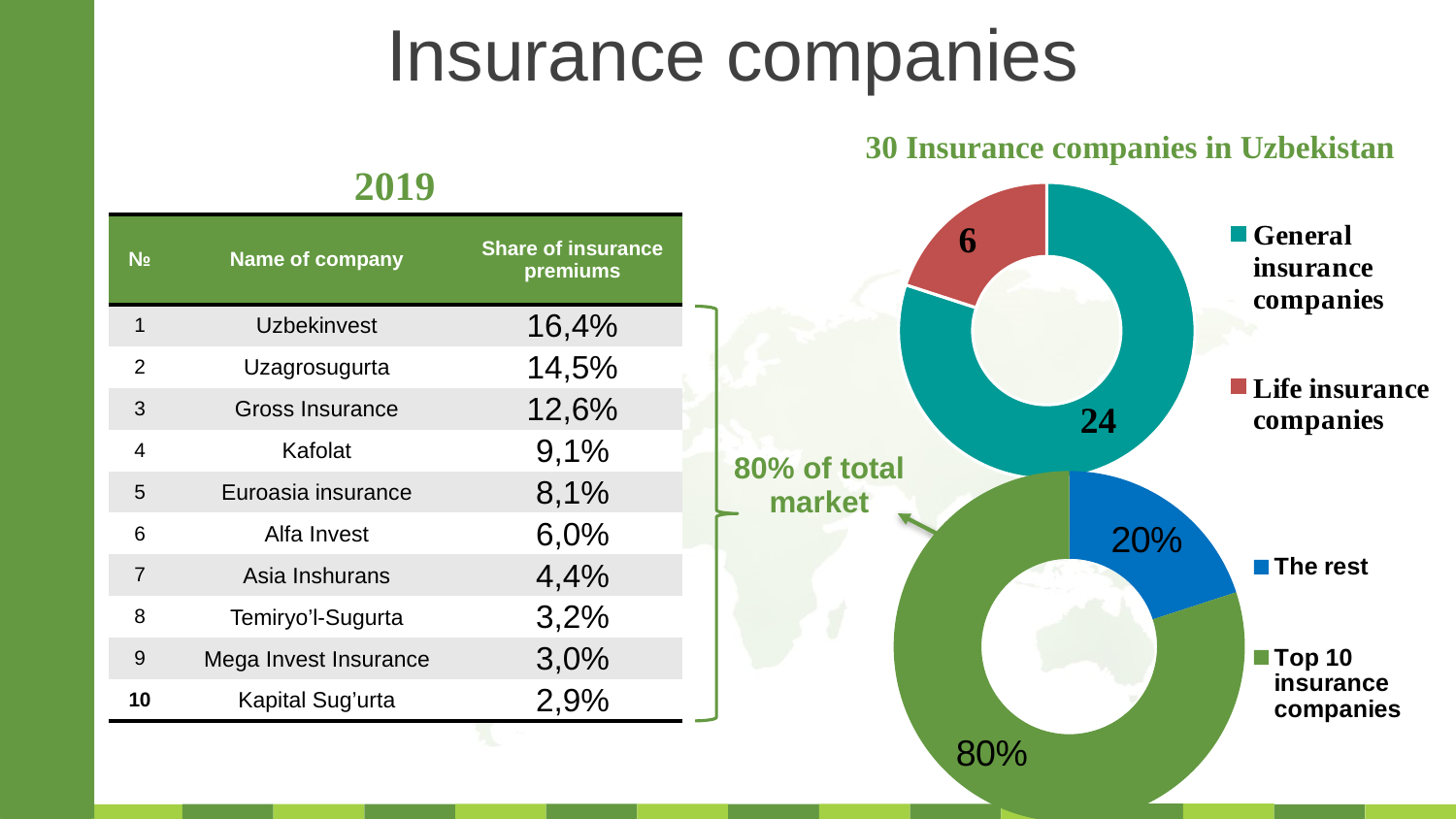
In the lower-right chart, what colour is the segment for 'The rest'? Blue What kind of chart is the one titled '30 Insurance companies in Uzbekistan'? Doughnut chart In the chart titled '30 Insurance companies in Uzbekistan', how many general insurance companies are shown? 24 In the lower-right chart, which segment is larger: 'Top 10 insurance companies' or 'The rest'? Top 10 insurance companies In the lower-right chart, what share of the market do the Top 10 insurance companies hold? 80% In the lower-right chart, what share of the market is labelled 'The rest'? 20% In the chart titled '30 Insurance companies in Uzbekistan', which category has the larger value? General insurance companies In the chart titled '30 Insurance companies in Uzbekistan', which category has the smaller value? Life insurance companies In the chart titled '30 Insurance companies in Uzbekistan', what is the total of the two segments? 30 In the chart titled '30 Insurance companies in Uzbekistan', how many categories does the legend list? 2 In the chart titled '30 Insurance companies in Uzbekistan', what is the difference between the number of general insurance companies and life insurance companies? 18 In the chart titled '30 Insurance companies in Uzbekistan', how many life insurance companies are shown? 6